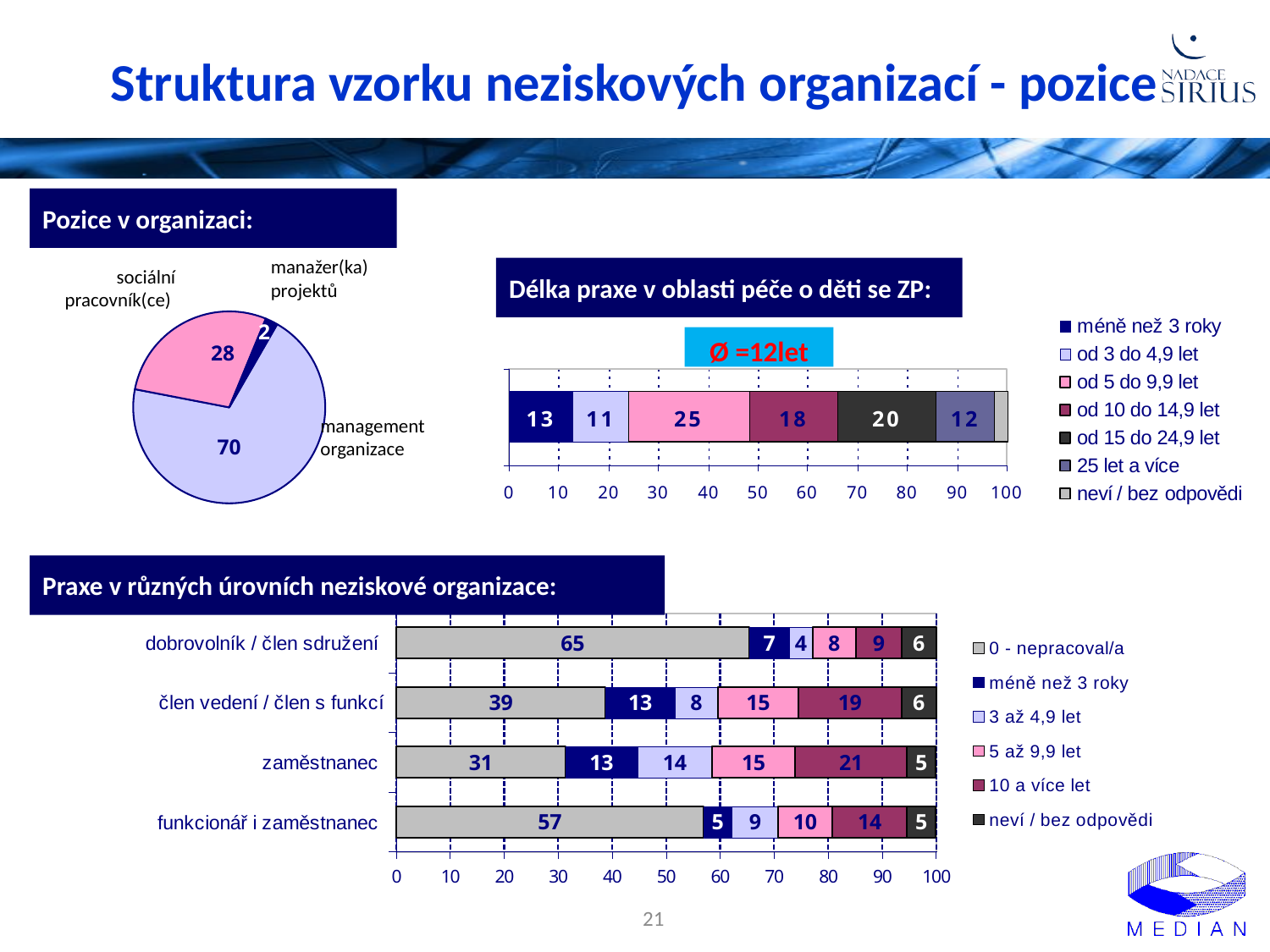
What kind of chart is 'Pozice v organizaci'? pie chart In the 'Pozice v organizaci' pie chart, what is the difference between 'management organizace' and 'sociální pracovník(ce)'? 42 In the 'Praxe v různých úrovních neziskové organizace' chart, what is the value of '10 a více let' for 'zaměstnanec'? 21 In the 'Délka praxe v oblasti péče o děti se ZP' chart, which segment is larger: 'od 15 do 24,9 let' or 'od 10 do 14,9 let'? od 15 do 24,9 let In the 'Pozice v organizaci' pie chart, what is the value for 'management organizace'? 70 In the 'Délka praxe v oblasti péče o děti se ZP' chart, what is the value for 'od 5 do 9,9 let'? 25 In the 'Praxe v různých úrovních neziskové organizace' chart, what is the value of '0 - nepracoval/a' for 'dobrovolník / člen sdružení'? 65 How many series does the legend of the 'Délka praxe v oblasti péče o děti se ZP' chart list? 7 What kind of chart is 'Praxe v různých úrovních neziskové organizace'? stacked bar chart How many categories are shown in the 'Praxe v různých úrovních neziskové organizace' chart? 4 In the 'Pozice v organizaci' pie chart, which category has the smallest slice? manažer(ka) projektů In the 'Praxe v různých úrovních neziskové organizace' chart, which category has the highest value for '0 - nepracoval/a'? dobrovolník / člen sdružení